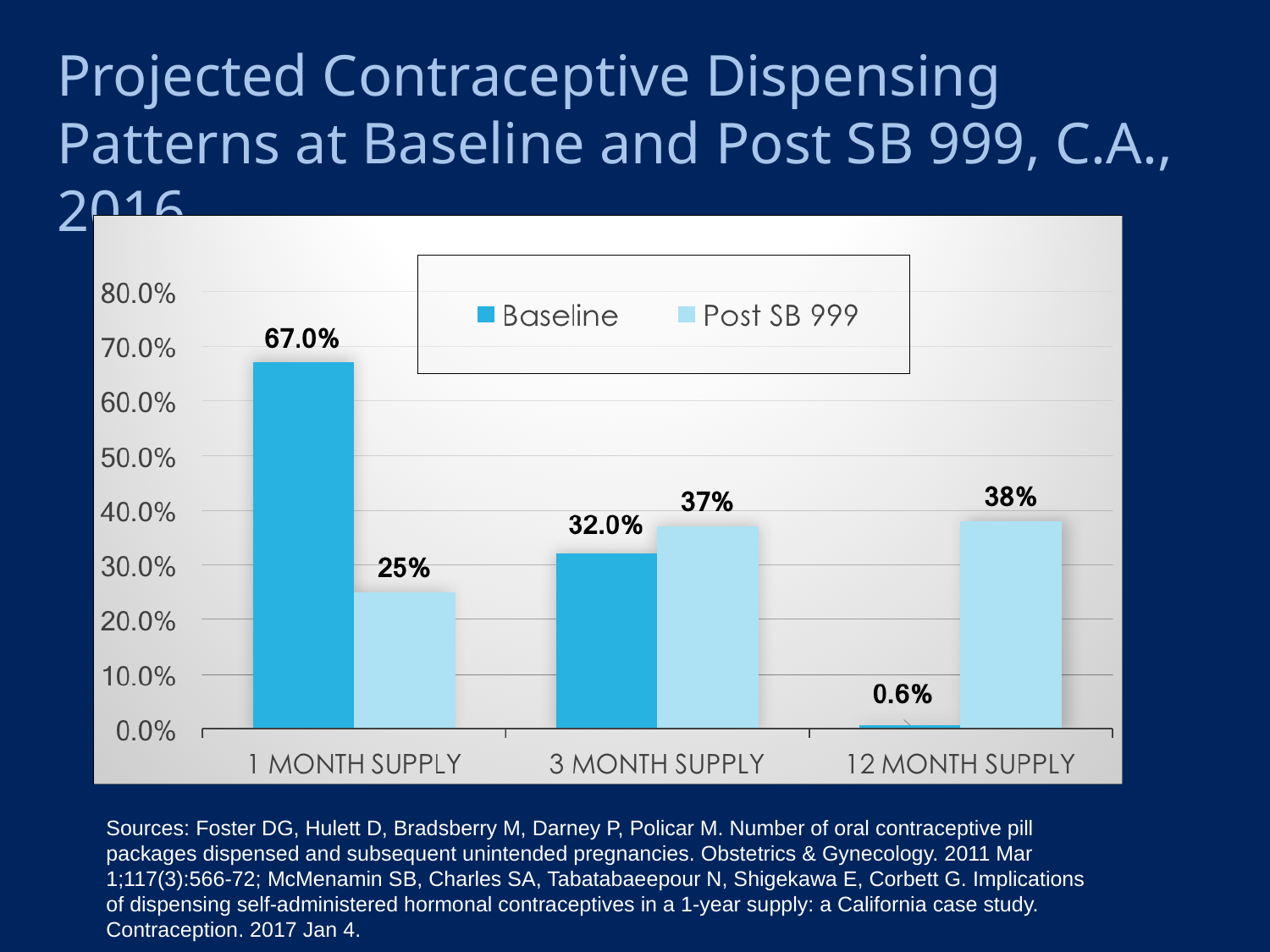
What kind of chart is shown on the slide? Bar chart What is the difference between the Baseline and Post SB 999 values for 1 Month Supply? 42 percentage points For 3 Month Supply, which is larger: the Baseline value or the Post SB 999 value? Post SB 999 Which supply category has the highest Baseline value? 1 Month Supply How many series does the legend list? 2 What is the Baseline value for 12 Month Supply? 0.6% Which supply category has the lowest Baseline value? 12 Month Supply How many supply categories are shown on the x axis? 3 Which supply category has the lowest Post SB 999 value? 1 Month Supply What is the Post SB 999 value for 3 Month Supply? 37% What is the Post SB 999 value for 12 Month Supply? 38% What is the Baseline value for 1 Month Supply? 67.0%